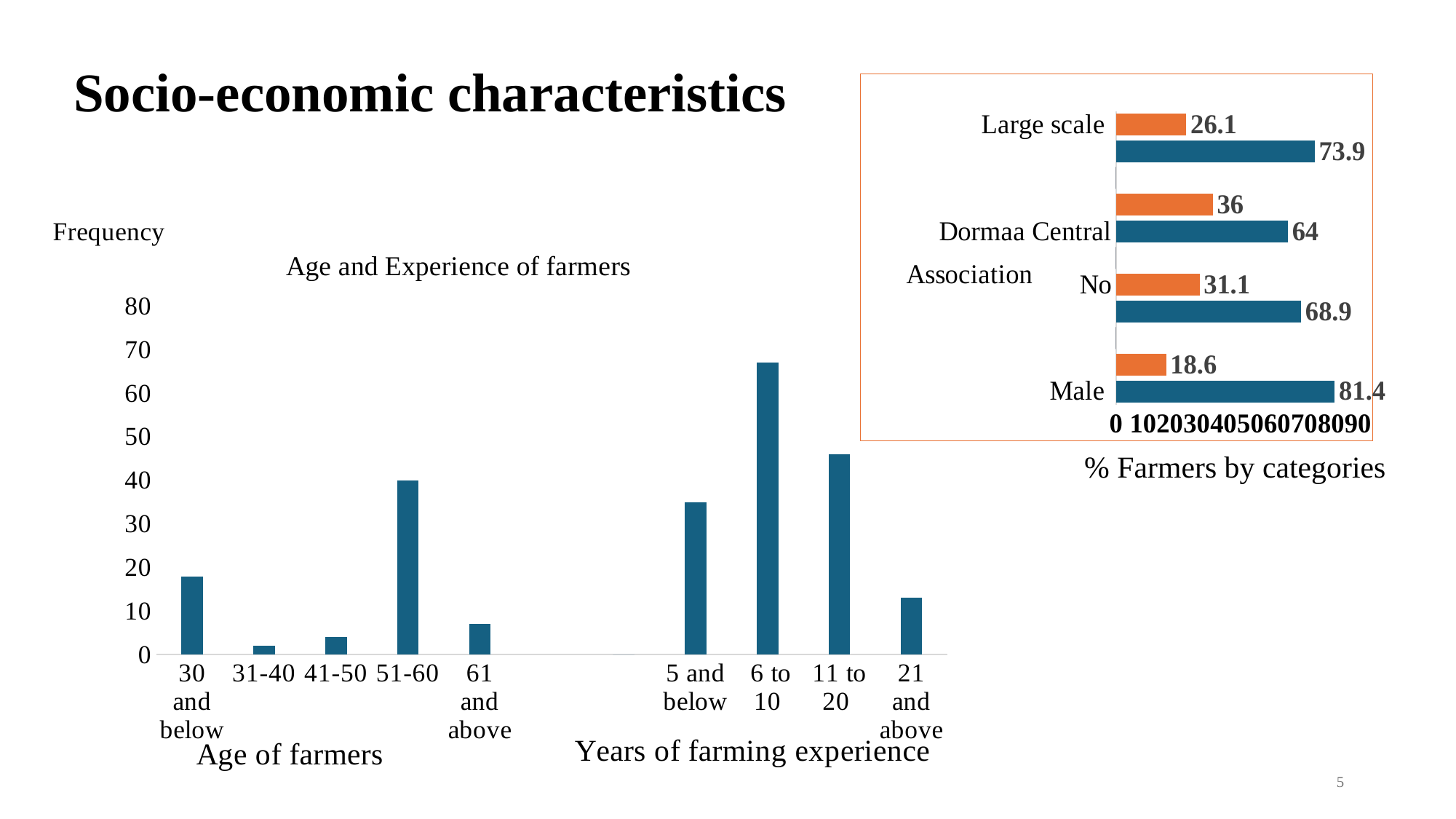
What kind of chart is the 'Age and Experience of farmers' chart? bar chart In the '% Farmers by categories' chart, what is the difference between the blue and orange bars for 'Large scale'? 47.8 In the '% Farmers by categories' chart, what is the value of the blue bar for 'Male'? 81.4 In the 'Age and Experience of farmers' chart, which age group has the lowest frequency? 31-40 In the 'Age and Experience of farmers' chart, which has the higher frequency: '30 and below' or '61 and above'? 30 and below In the 'Age and Experience of farmers' chart, is the frequency for '51-60' greater or less than 30? greater In the 'Age and Experience of farmers' chart, which years-of-farming-experience group has the highest frequency? 6 to 10 In the '% Farmers by categories' chart, what is the value of the orange bar for 'Dormaa Central'? 36 In the 'Age and Experience of farmers' chart, is the frequency for '6 to 10' years of experience greater or less than 60? greater How many age groups are shown in the 'Age and Experience of farmers' chart? 5 In the 'Age and Experience of farmers' chart, is the frequency for '21 and above' years of experience greater or less than 20? less In the 'Age and Experience of farmers' chart, which age group has the highest frequency? 51-60